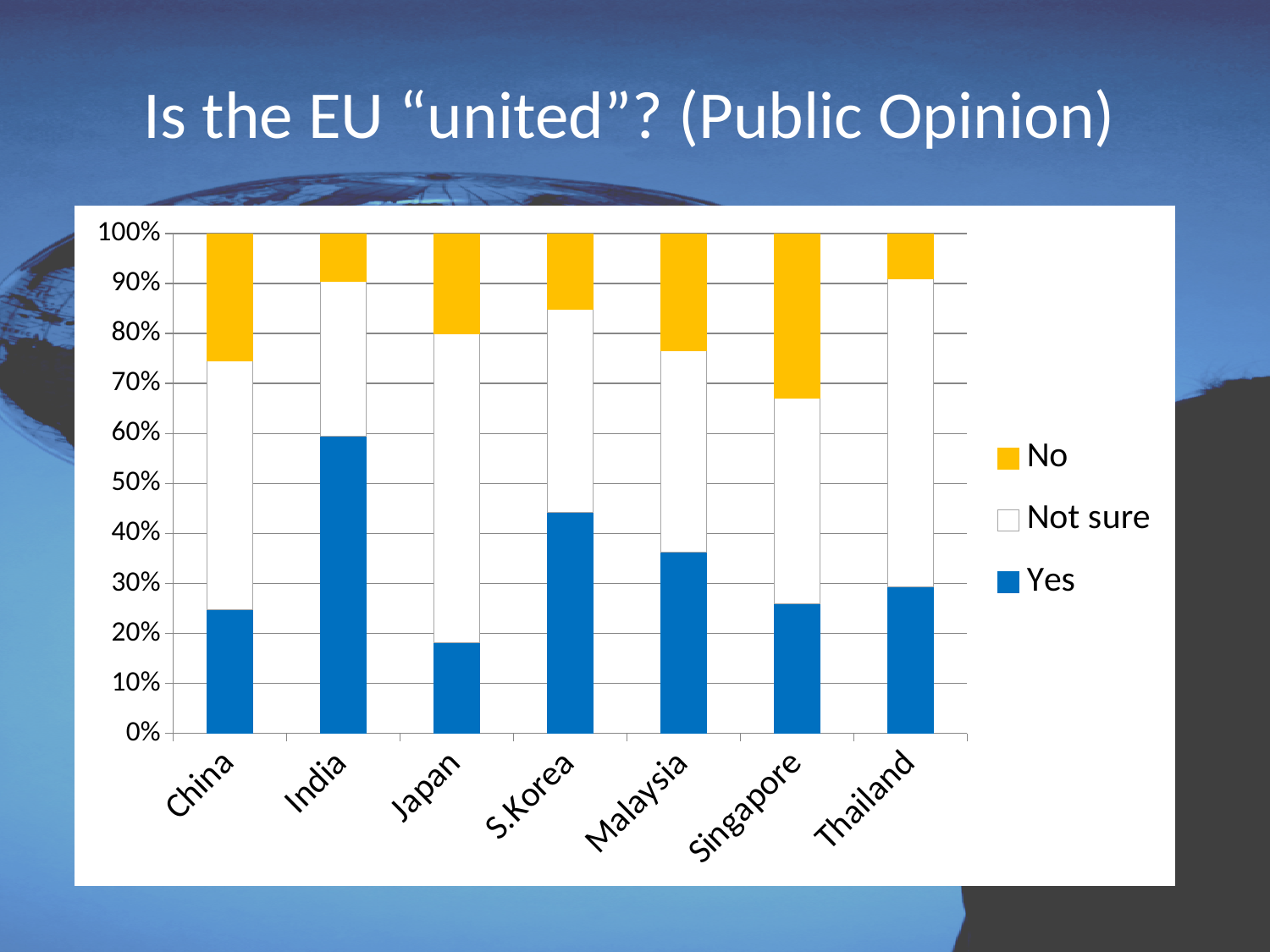
What colour represents the "No" series in the chart? Yellow Is the "Yes" value for China greater or less than 30%? less Which has a larger "No" share, Singapore or Thailand? Singapore What kind of chart is shown on the slide? Stacked bar chart Is the "Yes" value for India greater or less than 50%? greater Which country has the smallest "Yes" share in the chart? Japan Which country has the largest "Yes" share in the chart? India How many countries are shown on the x axis of the chart? 7 Which country has the largest "No" share in the chart? Singapore Which has a larger "Yes" share, India or S.Korea? India Is the "Yes" value for S.Korea greater or less than 40%? greater How many series does the chart legend list? 3